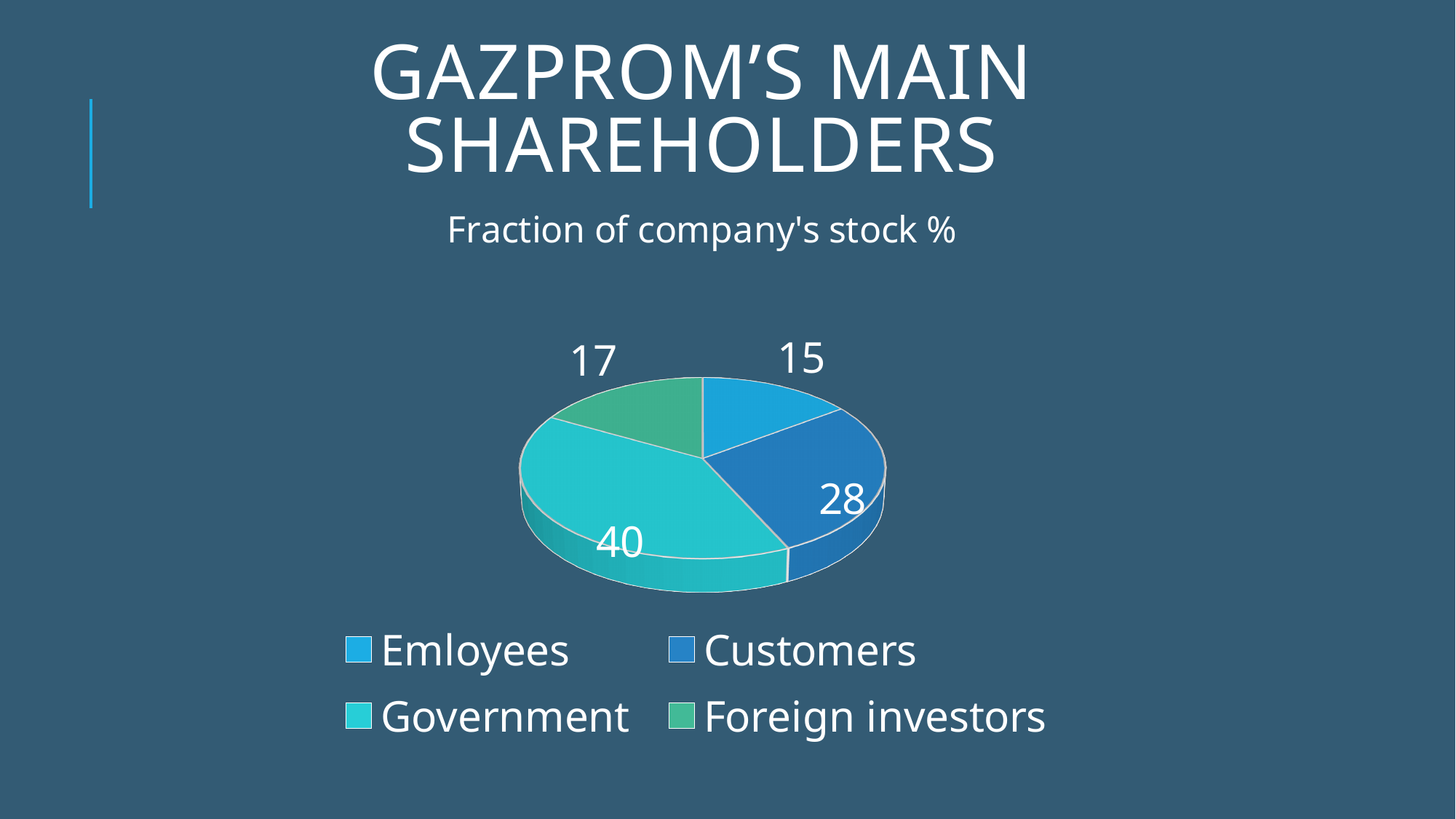
What share of the pie does the Government slice represent? 40% What is the value for Foreign investors in the pie chart? 17 What is the value for Customers in the pie chart? 28 What is the value for Emloyees in the pie chart? 15 Which category has the largest slice of the pie? Government What is the value for Government in the pie chart? 40 What is the difference between the values for Government and Customers? 12 What is the title of the chart? Fraction of company's stock % Which category has the smallest slice of the pie? Emloyees What kind of chart is shown on the slide? pie chart How many categories does the pie chart have? 4 Which is larger, the value for Customers or the value for Foreign investors? Customers